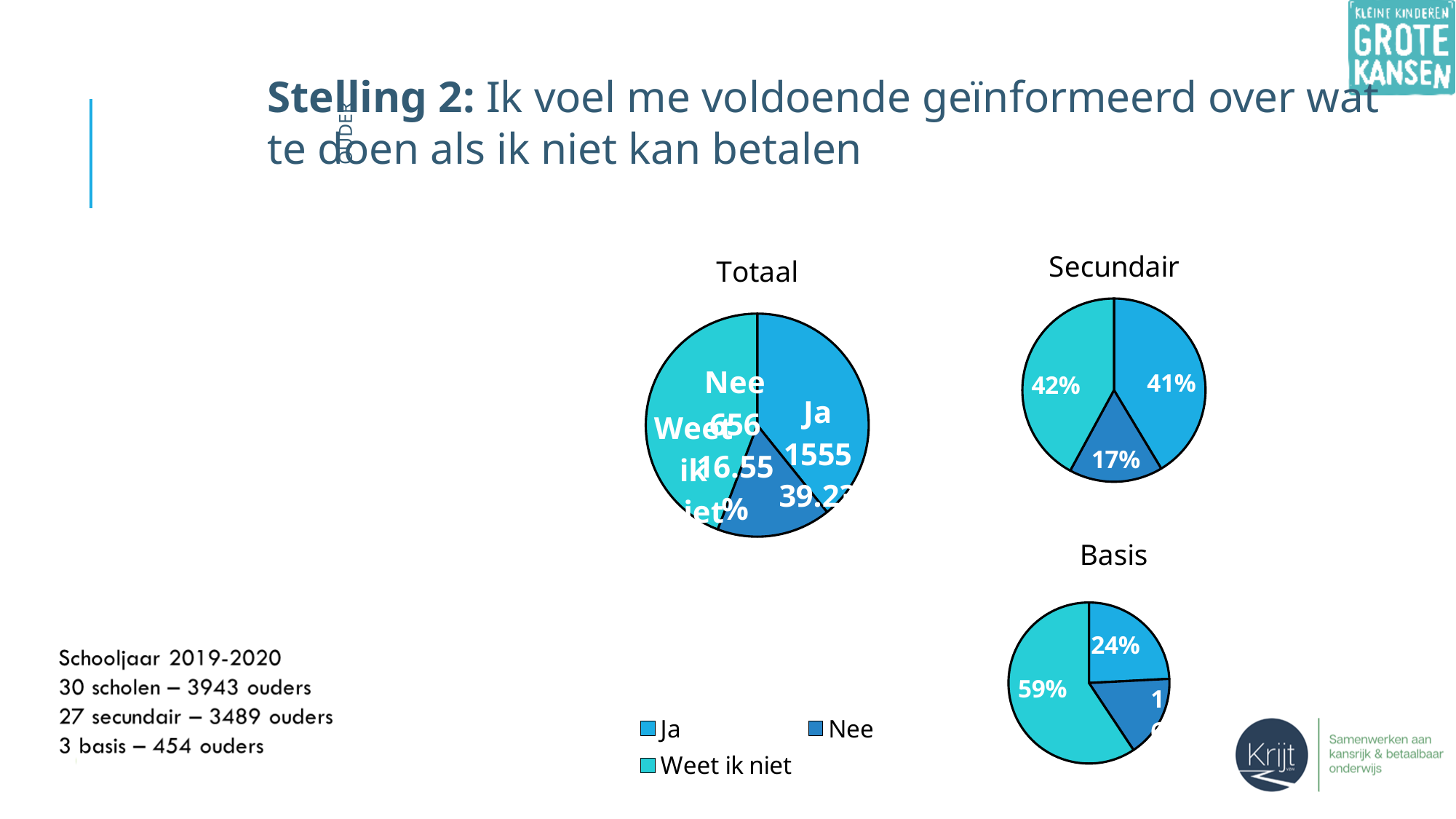
In the Totaal pie chart, what percentage is shown for Nee? 16.55% In the Basis pie chart, how many percentage points larger is Weet ik niet than Ja? 35 percentage points In the Basis pie chart, which category has the largest share? Weet ik niet How many categories does the legend list for the pie charts? 3 In the Totaal pie chart, what count is shown for Nee? 656 In the Secundair pie chart, which category has the smallest share? Nee In the Basis pie chart, what percentage is shown for Ja? 24% In the Secundair pie chart, what percentage is shown for Weet ik niet? 42% In the Basis pie chart, what percentage is shown for Weet ik niet? 59% In the Secundair pie chart, what percentage is shown for Nee? 17% In the Secundair pie chart, what percentage is shown for Ja? 41% In the Totaal pie chart, what count is shown for Ja? 1555